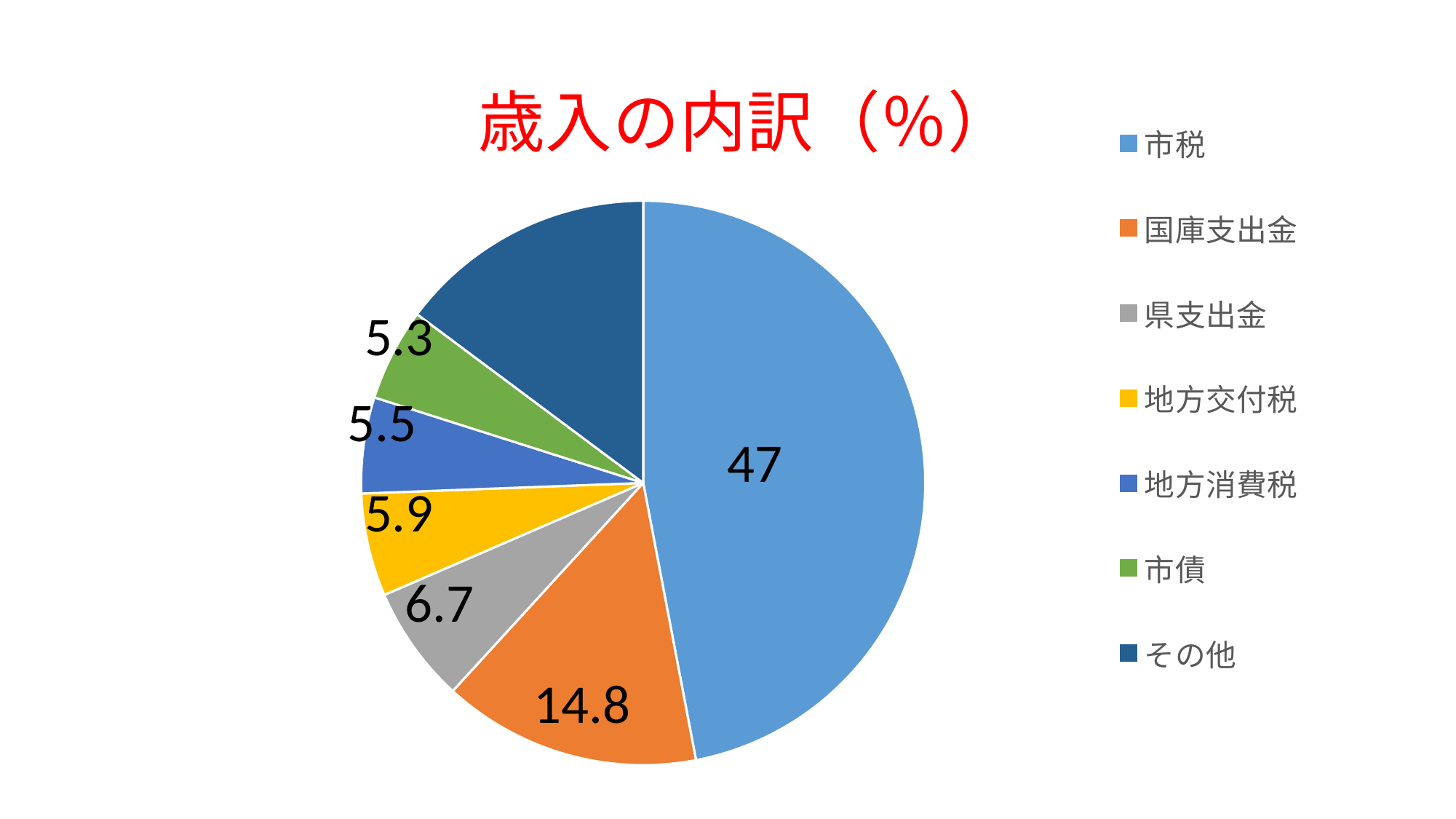
Which category has the largest slice of the pie? 市税 What is the value shown for 県支出金? 6.7 What is the value shown for 市債? 5.3 What is the difference between the values for 市税 and 国庫支出金? 32.2 What is the value shown for 地方交付税? 5.9 What is the title of the chart? 歳入の内訳（%） How many categories does the legend list? 7 Which of the labelled slices has the smallest value? 市債 What is the value shown for 国庫支出金? 14.8 What is the value shown for 市税? 47 Which is larger, the value for 地方消費税 or the value for 地方交付税? 地方交付税 What type of chart is shown on the slide? pie chart